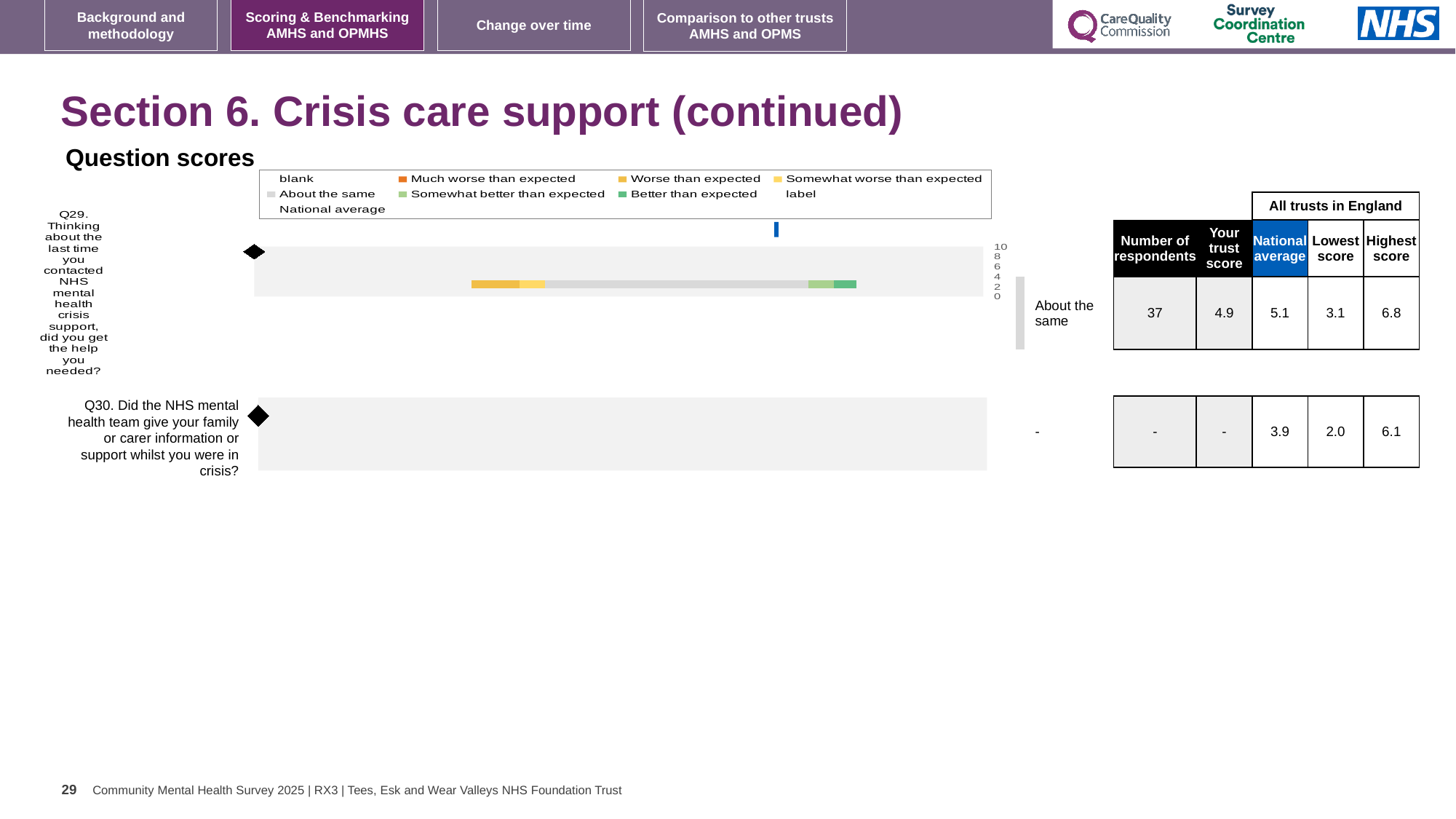
What is the difference between the highest and lowest scores for Q30? 4.1 Which benchmark category is shown for Q29? About the same What is the national average score for Q29? 5.1 What is the trust score for Q29 (did you get the help you needed from NHS mental health crisis support)? 4.9 What is the difference between the national average and the trust score for Q29? 0.2 Which colour does the legend use for 'Better than expected'? green Which is larger for Q29, the trust score or the national average? national average What is the highest score among all trusts in England for Q29? 6.8 Which colour does the legend use for 'Much worse than expected'? orange What kind of chart is used to show the question scores on this slide? bar chart How many respondents answered Q29? 37 How many questions are plotted in the question scores chart? 2